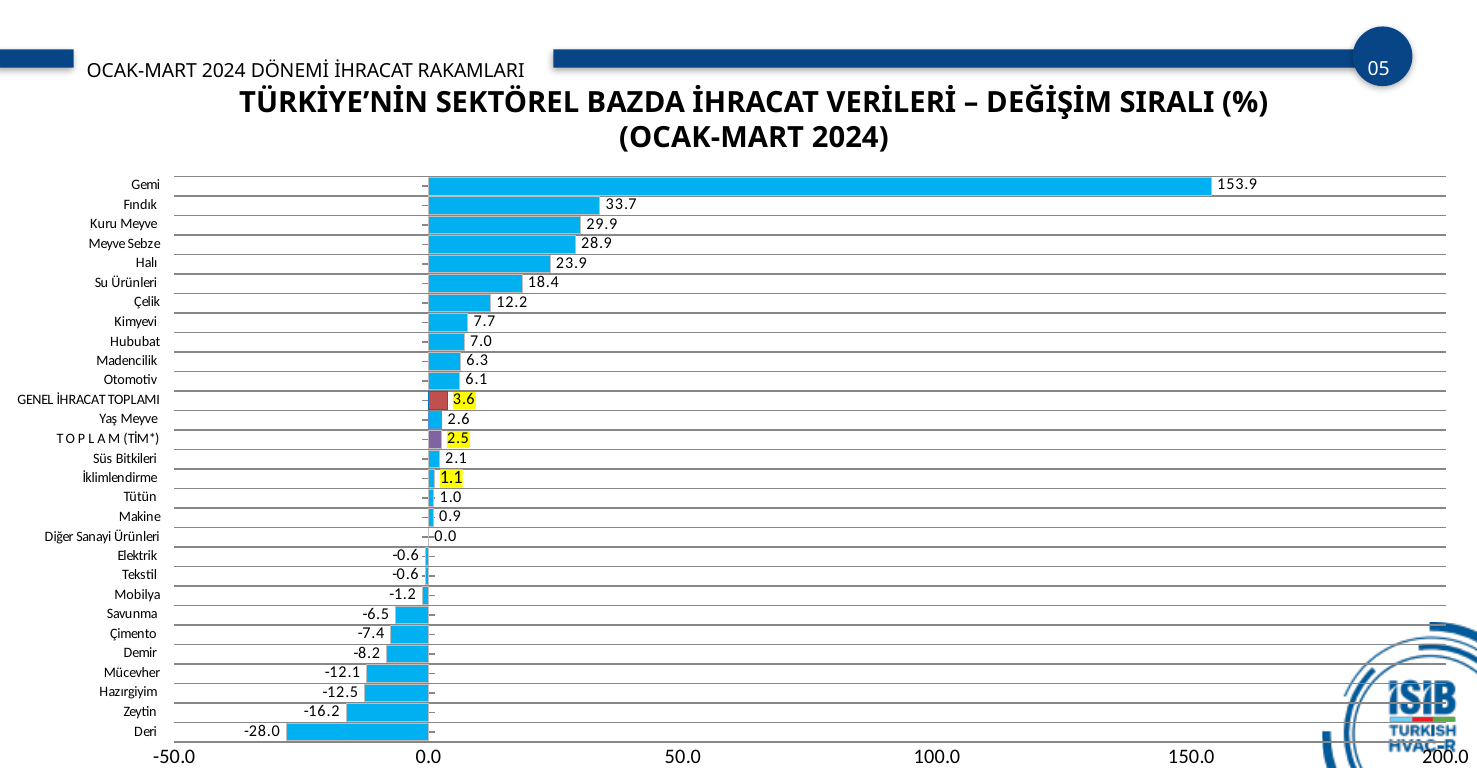
What is the value for GENEL İHRACAT TOPLAMI? 3.6 How many categories are shown in the chart? 29 Is the value for Gemi greater or less than 150.0? greater What kind of chart is shown on the slide? Bar chart Which category has the lowest value? Deri What is the difference between the values for Fındık and Kuru Meyve? 3.8 What is the value for Deri? -28.0 What is the value for Zeytin? -16.2 Which is larger, the value for Halı or the value for Su Ürünleri? Halı What is the value for Gemi? 153.9 What is the value for İklimlendirme? 1.1 Which category has the highest value? Gemi